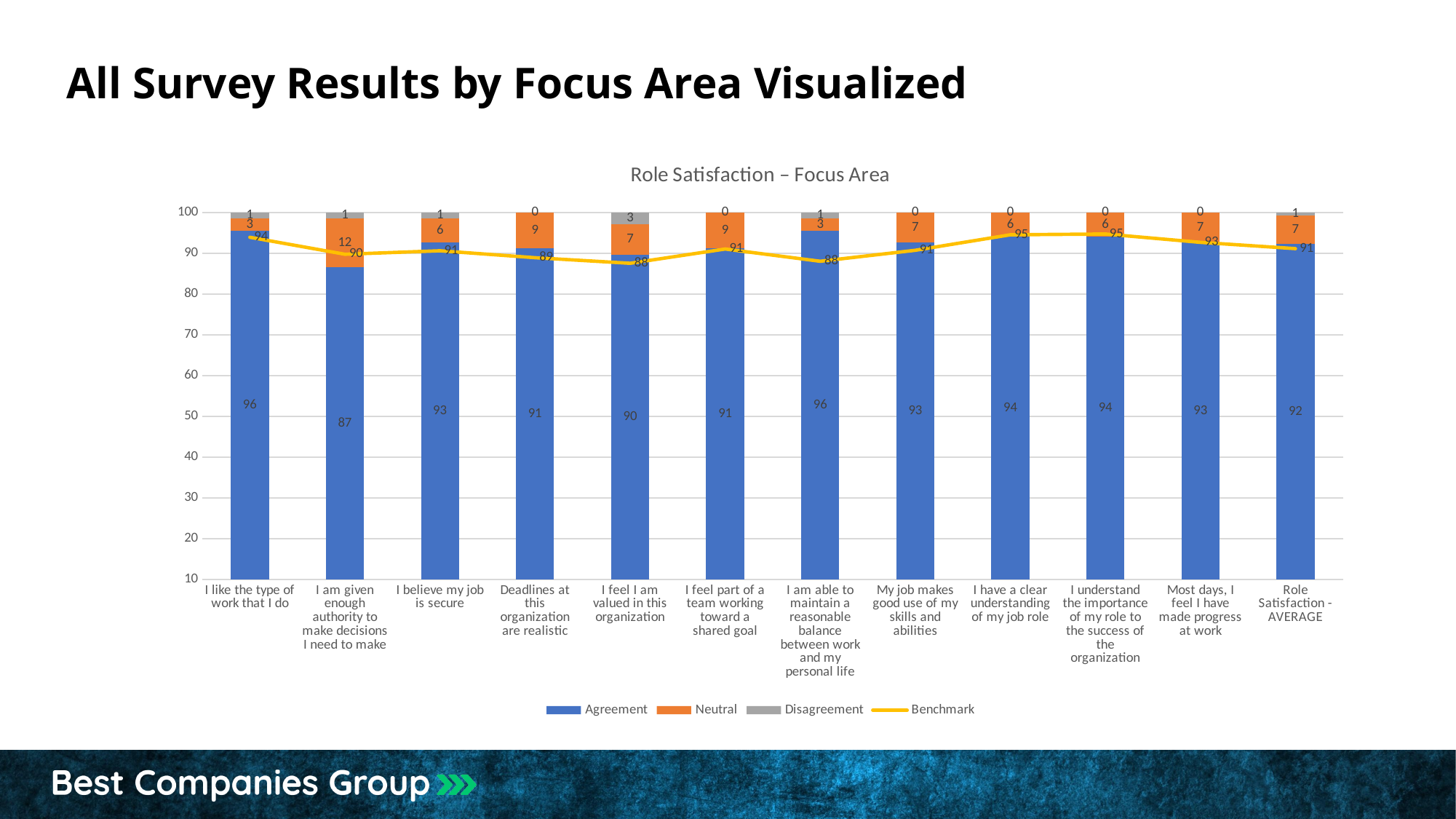
What is the total of the stacked bar for "I feel I am valued in this organization" (Agreement + Neutral + Disagreement)? 100 What is the Agreement value for "Role Satisfaction - AVERAGE"? 92 What is the Agreement value for "I am given enough authority to make decisions I need to make"? 87 How many categories are shown on the x axis? 12 How many series does the legend list? 4 Which category has the lowest Agreement value? I am given enough authority to make decisions I need to make What is the Benchmark value for "I have a clear understanding of my job role"? 95 What is the difference between the Agreement value for "I like the type of work that I do" and the Agreement value for "I feel I am valued in this organization"? 6 Which is larger: the Agreement value for "I believe my job is secure" or the Agreement value for "I feel part of a team working toward a shared goal"? I believe my job is secure Which category has the highest Neutral value? I am given enough authority to make decisions I need to make What is the Neutral value for "Deadlines at this organization are realistic"? 9 What kind of chart is shown on the slide? Stacked bar chart with a benchmark line